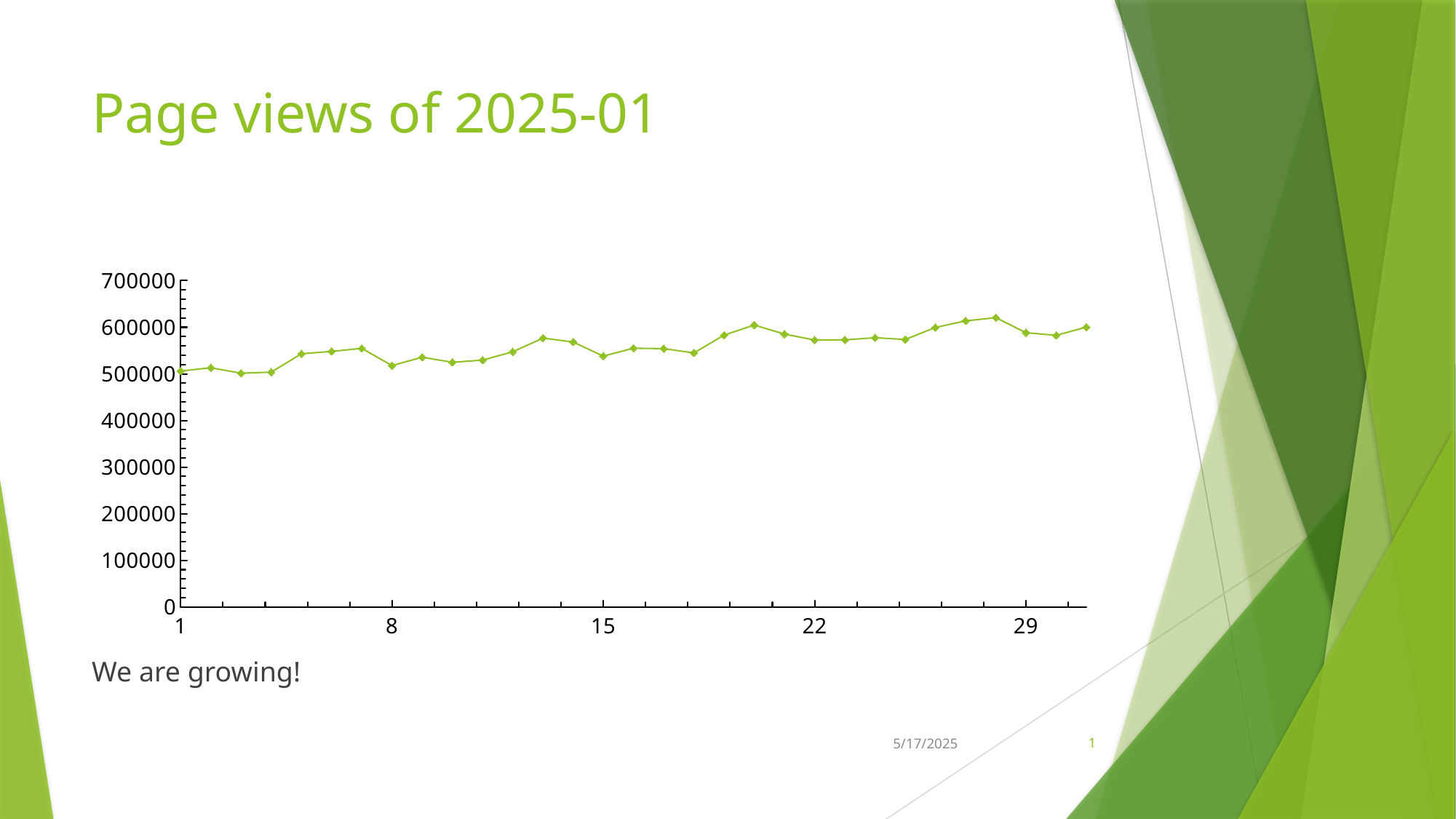
Is the value for day 8 greater or less than 600000? less How many data points are plotted on the line? 31 Which has the larger value, day 8 or day 12? day 12 What colour is the plotted line? green What kind of chart is shown on the slide? line chart Is the value for day 15 greater or less than 500000? greater Do the page views generally rise or fall from day 1 to day 31? rise Is the value for day 1 greater or less than 600000? less What is the title of the slide containing the chart? Page views of 2025-01 Which has the larger value, day 1 or day 31? day 31